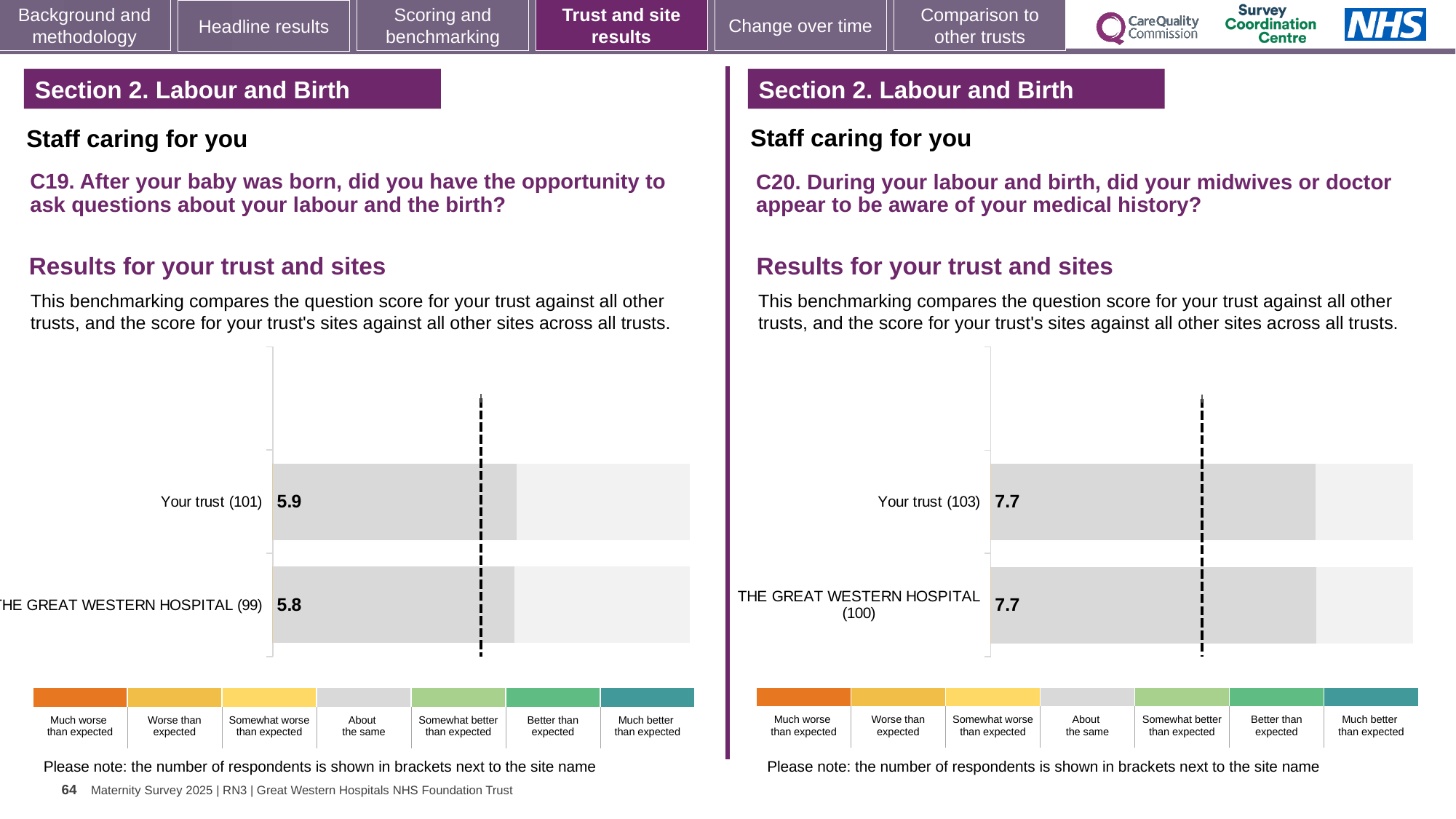
In the C20 chart on the right, what is the score for Your trust (103)? 7.7 What kind of chart is the C20 chart on the right? Bar chart In the C19 chart on the left, what is the score for Your trust (101)? 5.9 In the C19 chart on the left, what is the score for THE GREAT WESTERN HOSPITAL (99)? 5.8 In the C19 chart on the left, what is the difference between the score for Your trust (101) and the score for THE GREAT WESTERN HOSPITAL (99)? 0.1 How many respondents are shown in brackets for Your trust in the C20 chart on the right? 103 In the C19 chart on the left, which has the higher score: Your trust (101) or THE GREAT WESTERN HOSPITAL (99)? Your trust (101) In the C20 chart on the right, what is the difference between the score for Your trust (103) and the score for THE GREAT WESTERN HOSPITAL (100)? 0 In the C20 chart on the right, what is the score for THE GREAT WESTERN HOSPITAL (100)? 7.7 How many bars are plotted in the C20 chart on the right? 2 How many bars are plotted in the C19 chart on the left? 2 How many categories does the colour key below the C19 chart on the left list? 7